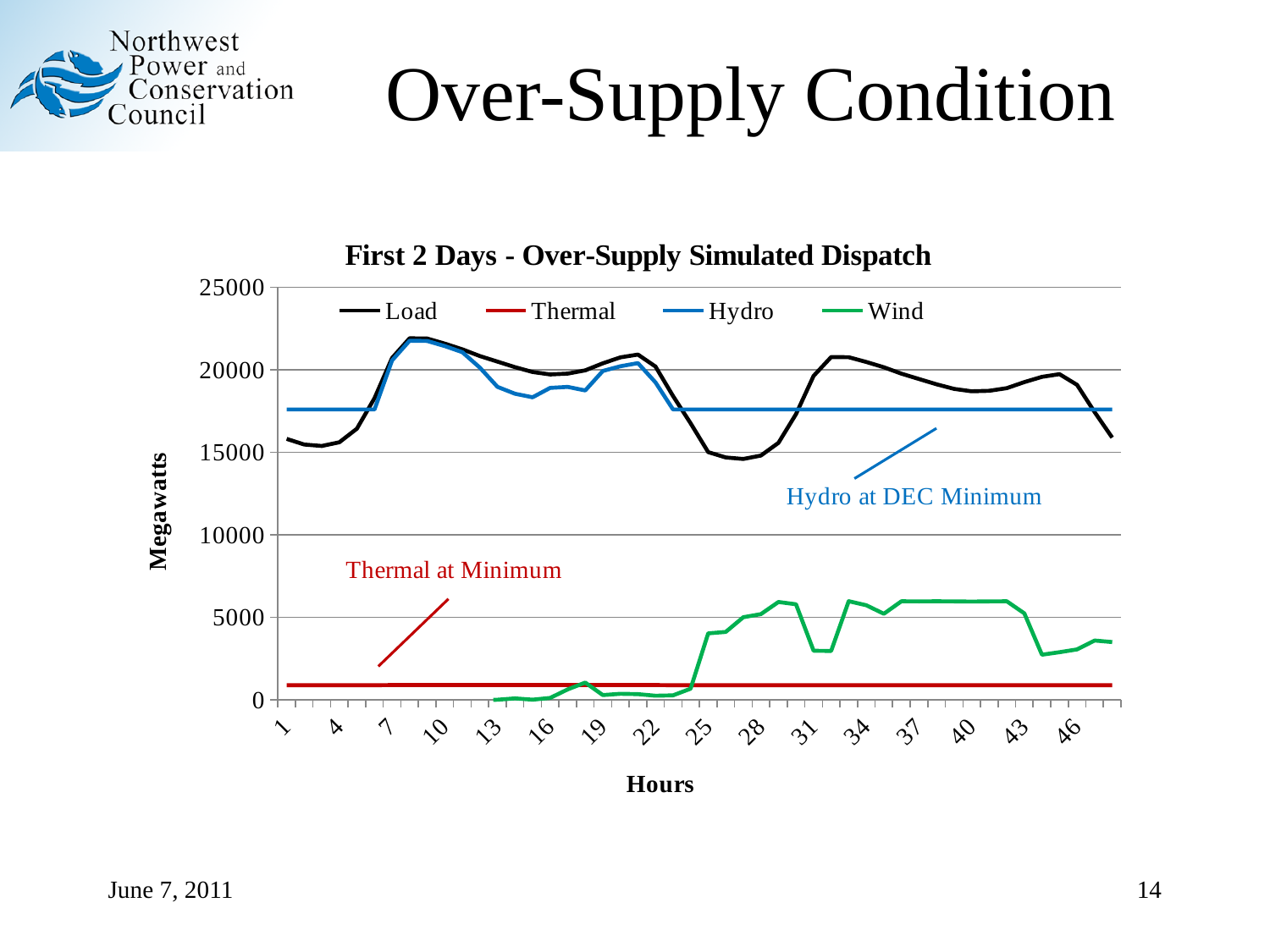
How many series does the legend list? 4 Does the Wind series rise or fall between hour 22 and hour 28? rise Is the Load value at hour 10 greater or less than 20000? greater What kind of chart is shown on the slide? line chart What is the title of the chart? First 2 Days - Over-Supply Simulated Dispatch At hour 25, which is larger, Load or Hydro? Hydro Is the Wind value at hour 37 greater or less than 5000? greater Is the Hydro value at hour 31 greater or less than 20000? less What is the label on the vertical axis of the chart? Megawatts